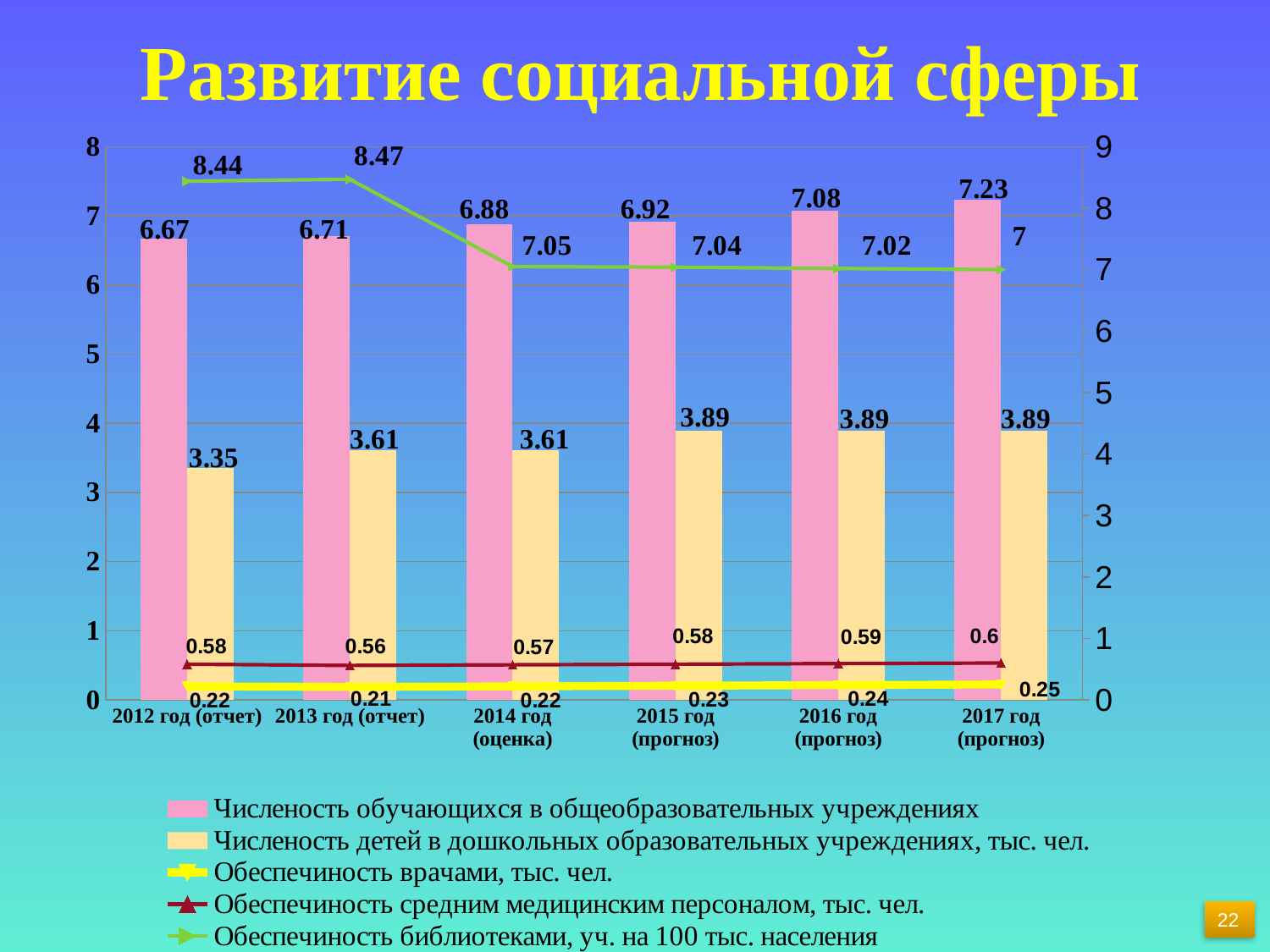
What is the value of 'Обеспечиность библиотеками, уч. на 100 тыс. населения' for 2013 год (отчет)? 8.47 Does 'Численость обучающихся в общеобразовательных учреждениях' rise or fall from 2012 to 2017? rise How many series does the legend list? 5 What is the value of 'Обеспечиность врачами, тыс. чел.' for 2016 год (прогноз)? 0.24 What is the title of the slide chart? Развитие социальной сферы How many year categories are shown on the x axis? 6 What is the difference between 'Численость обучающихся в общеобразовательных учреждениях' in 2017 год (прогноз) and 2012 год (отчет)? 0.56 In which year is 'Численость обучающихся в общеобразовательных учреждениях' the highest? 2017 год (прогноз) What is the value of 'Численость обучающихся в общеобразовательных учреждениях' for 2017 год (прогноз)? 7.23 In which year is 'Обеспечиность библиотеками, уч. на 100 тыс. населения' the lowest? 2017 год (прогноз) Which is larger for 2014 год (оценка): 'Численость обучающихся в общеобразовательных учреждениях' or 'Численость детей в дошкольных образовательных учреждениях, тыс. чел.'? Численость обучающихся в общеобразовательных учреждениях What is the value of 'Численость детей в дошкольных образовательных учреждениях, тыс. чел.' for 2012 год (отчет)? 3.35